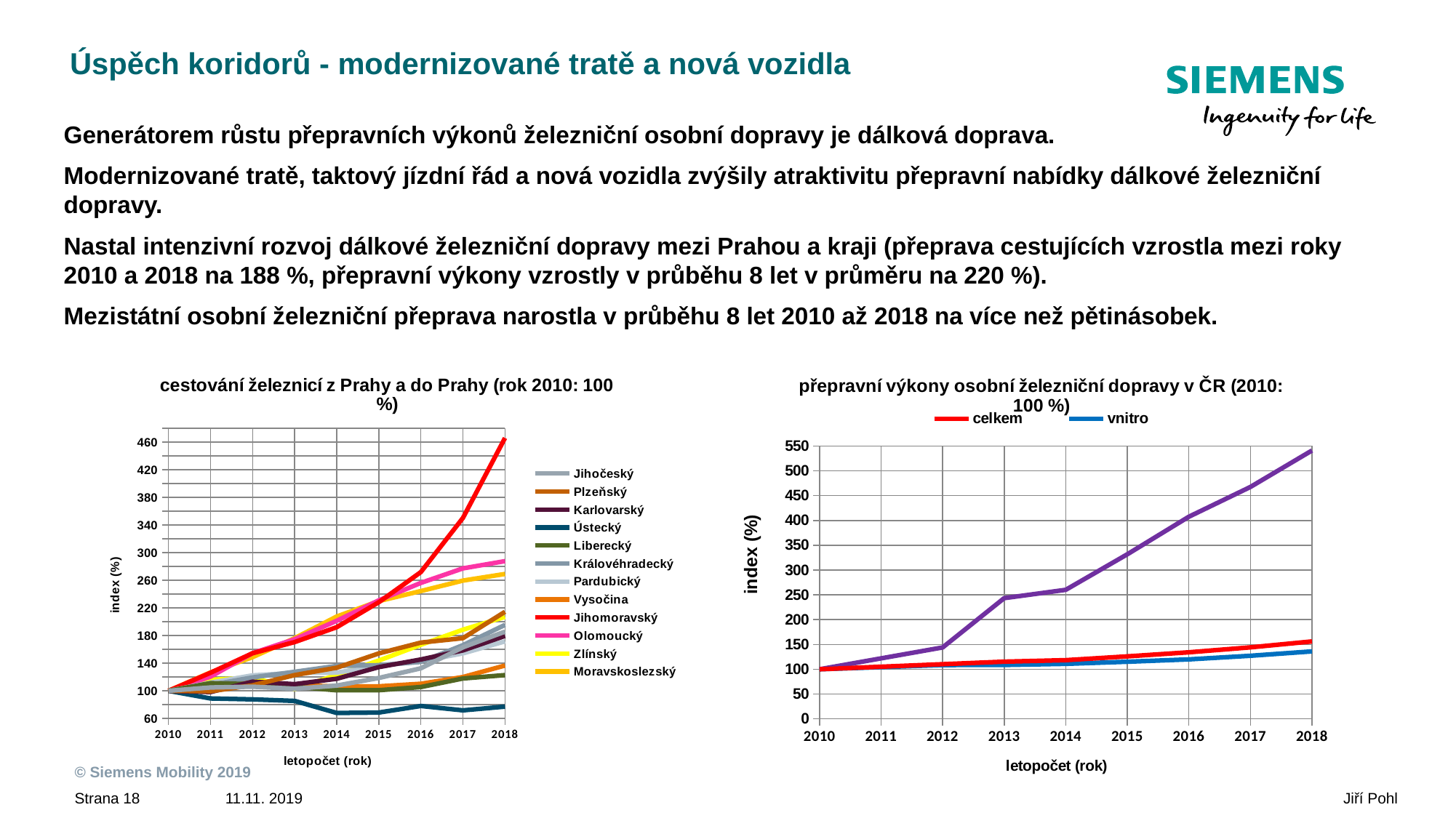
In the left chart, is the value for Ústecký in 2018 greater or less than 100? less How many series does the legend of the left chart list? 12 What kind of chart is the left chart titled 'cestování železnicí z Prahy a do Prahy'? line chart In the left chart, is the value for Jihomoravský in 2018 greater or less than 420? greater In the right chart, is the value of the purple line in 2018 greater or less than 500? greater In the left chart, does the Ústecký line rise or fall from 2010 to 2018? fall In the left chart, which region has the highest index in 2018? Jihomoravský How many years are shown on the x axis of the left chart? 9 In the left chart, which region has the lowest index in 2018? Ústecký How many series does the legend of the right chart titled 'přepravní výkony osobní železniční dopravy v ČR' list? 2 In the right chart, which is larger in 2018, celkem or vnitro? celkem